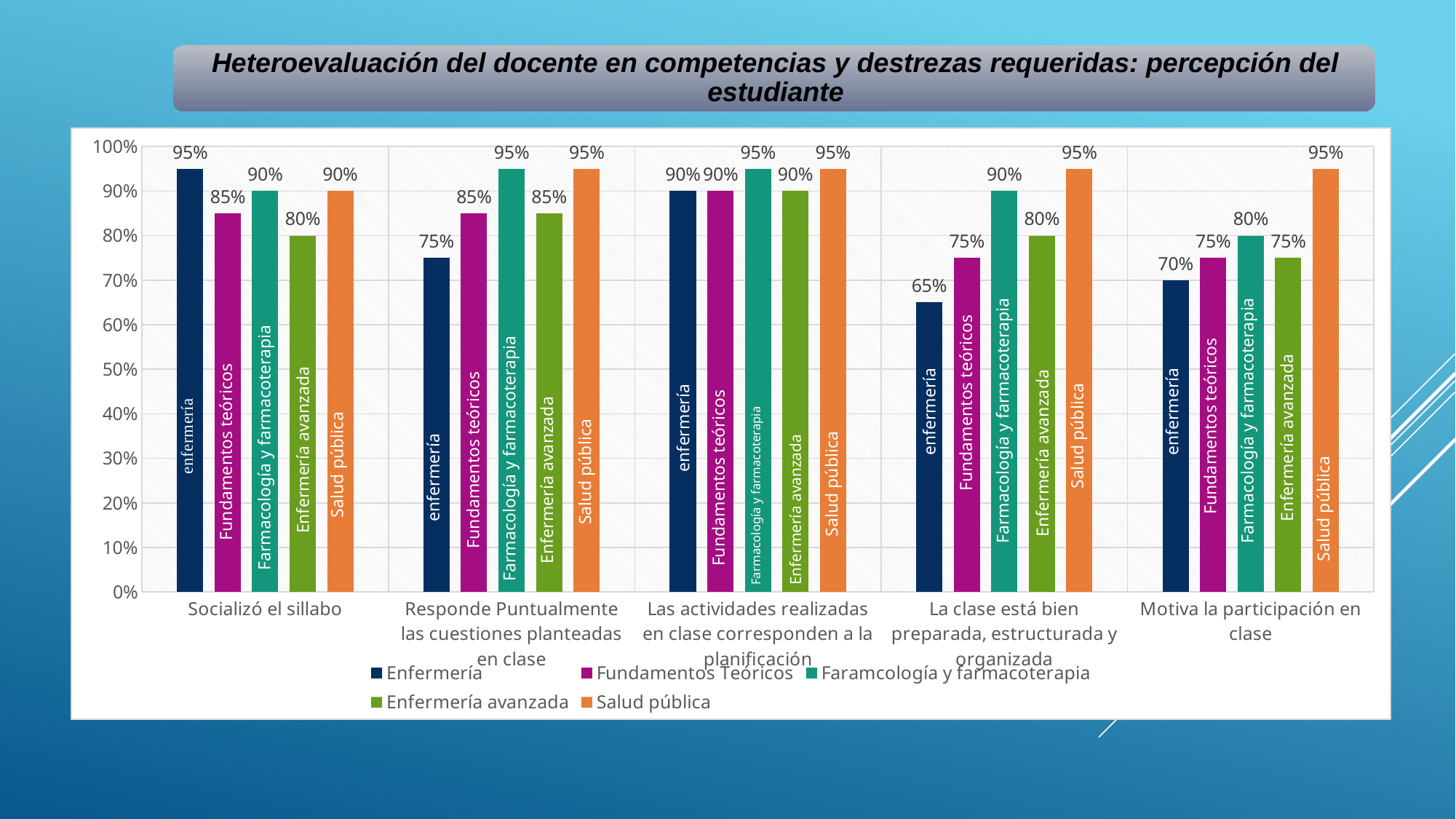
What is the value for Enfermería avanzada in the category "La clase está bien preparada, estructurada y organizada"? 80% What kind of chart is shown on the slide? Bar chart What is the value for Fundamentos Teóricos in the category "Responde Puntualmente las cuestiones planteadas en clase"? 85% What is the value for Enfermería in the category "Socializó el sillabo"? 95% Which series has the lowest value in the category "La clase está bien preparada, estructurada y organizada"? Enfermería How many series does the legend list? 5 Which series has the highest value in the category "Socializó el sillabo"? Enfermería How many categories are shown on the x axis? 5 What is the value for Salud pública in the category "Motiva la participación en clase"? 95% What is the difference between the Salud pública and Enfermería values in the category "Motiva la participación en clase"? 25% Which colour represents Salud pública in the chart? Orange In the category "Responde Puntualmente las cuestiones planteadas en clase", which is larger: the value for Enfermería or the value for Faramcología y farmacoterapia? Faramcología y farmacoterapia